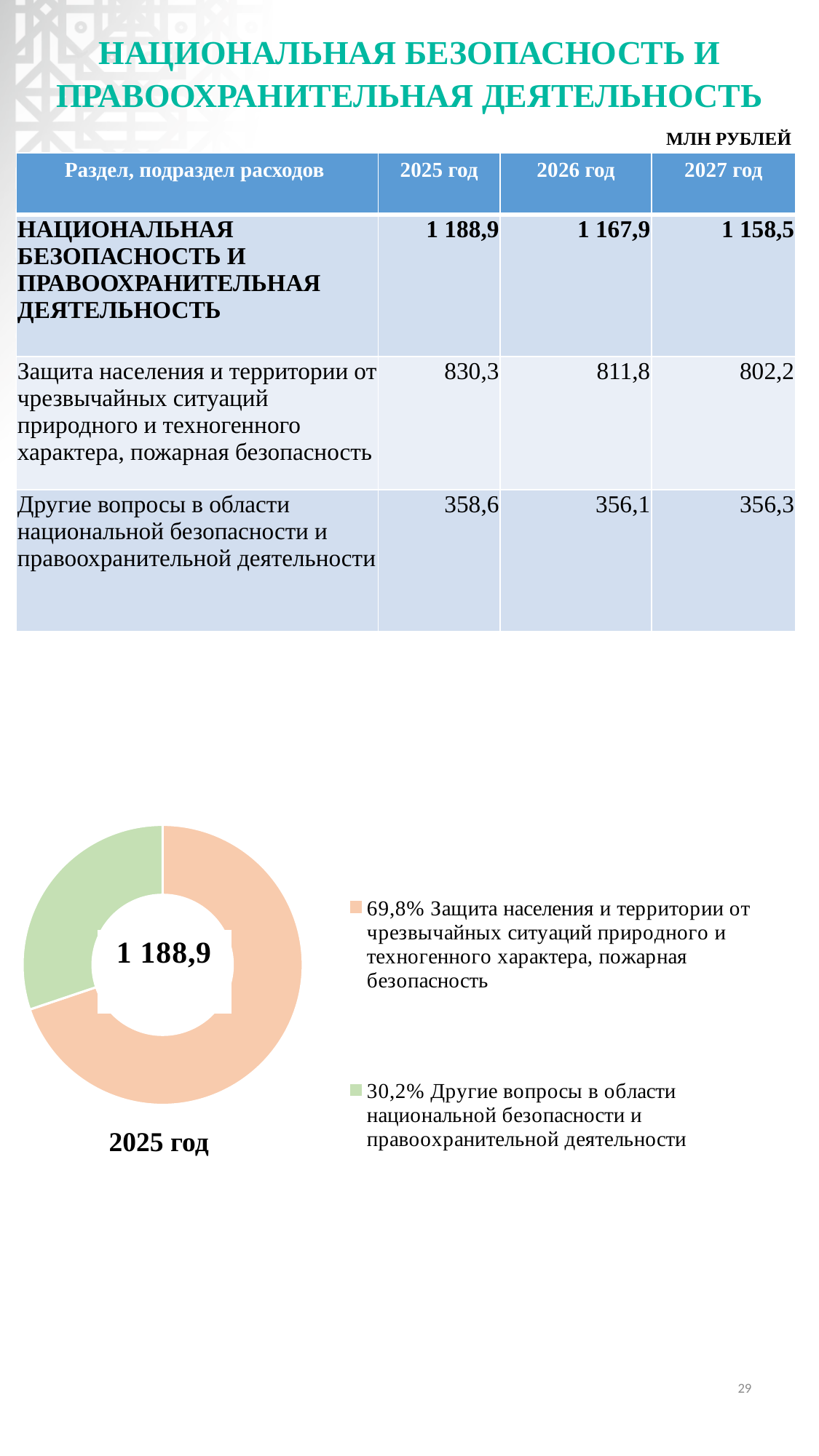
What colour is the slice for 'Защита населения и территории от чрезвычайных ситуаций...' in the doughnut chart? Orange (peach) How many slices does the doughnut chart have? 2 What is the difference in percentage points between the two slices of the doughnut chart (69,8% and 30,2%)? 39,6 Which slice is larger: 'Защита населения и территории...' or 'Другие вопросы в области национальной безопасности...'? Защита населения и территории от чрезвычайных ситуаций природного и техногенного характера, пожарная безопасность How many entries does the legend of the doughnut chart list? 2 Which category has the smallest slice in the doughnut chart? Другие вопросы в области национальной безопасности и правоохранительной деятельности What share of the 2025 doughnut chart is taken by 'Другие вопросы в области национальной безопасности и правоохранительной деятельности'? 30,2% Which category has the largest slice in the doughnut chart? Защита населения и территории от чрезвычайных ситуаций природного и техногенного характера, пожарная безопасность What share of the 2025 doughnut chart is taken by 'Защита населения и территории от чрезвычайных ситуаций природного и техногенного характера, пожарная безопасность'? 69,8% What kind of chart is shown on the slide? Doughnut (pie) chart Which year does the doughnut chart represent, according to the label below it? 2025 год What value is printed in the centre of the doughnut chart? 1 188,9